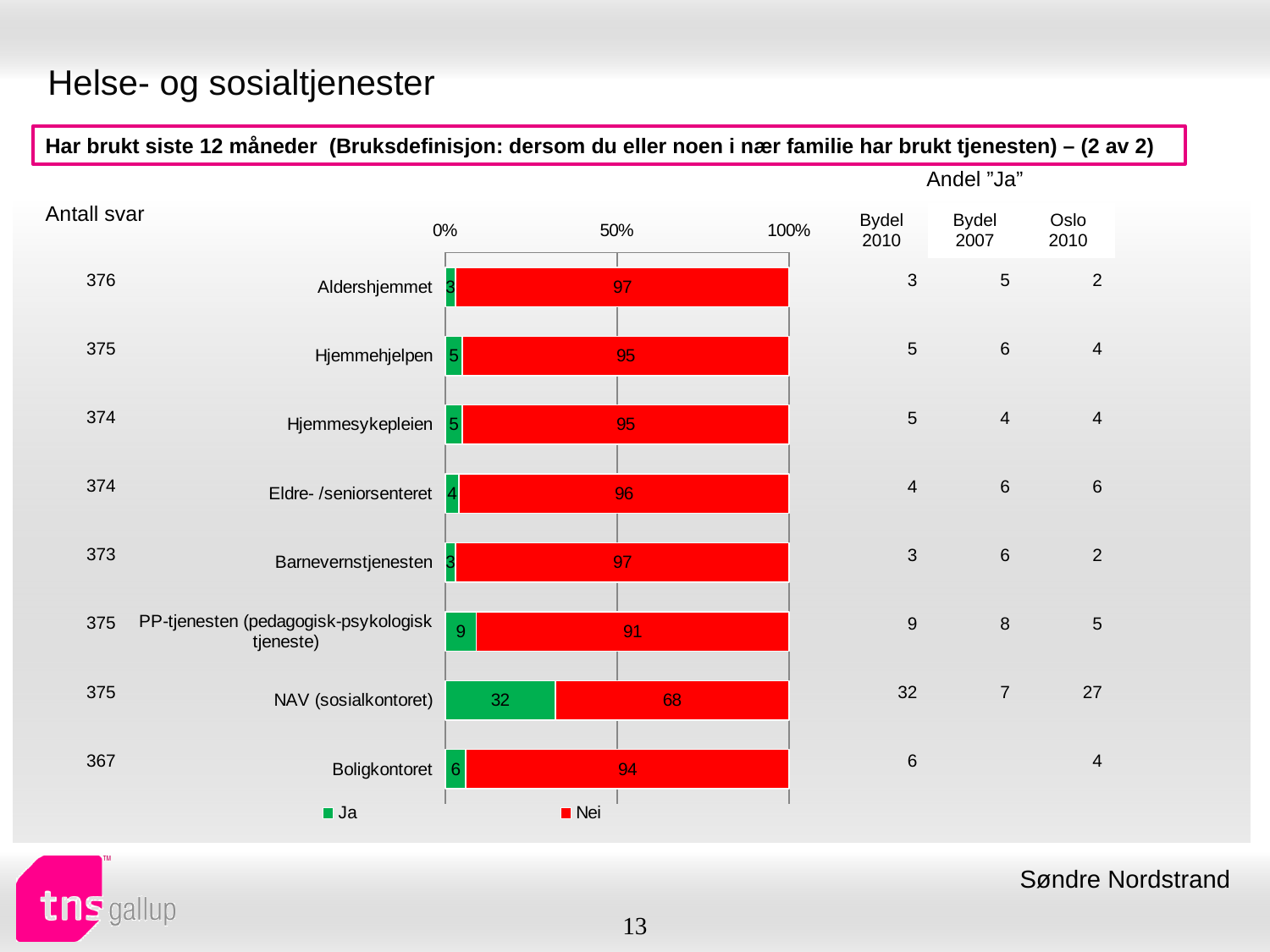
How many series does the legend list? 2 What is the total of the stacked bar for Eldre- /seniorsenteret? 100 What is the "Ja" value for Boligkontoret? 6 What is the "Nei" value for Aldershjemmet? 97 How many categories are shown in the chart? 8 Which category has the highest "Ja" value? NAV (sosialkontoret) What kind of chart is shown on the slide? Stacked bar chart Which is larger, the "Ja" value for Hjemmehjelpen or the "Ja" value for Barnevernstjenesten? Hjemmehjelpen Which category has the lowest "Nei" value? NAV (sosialkontoret) What is the "Nei" value for NAV (sosialkontoret)? 68 What is the difference between the "Ja" values for NAV (sosialkontoret) and PP-tjenesten (pedagogisk-psykologisk tjeneste)? 23 What is the "Ja" value for PP-tjenesten (pedagogisk-psykologisk tjeneste)? 9